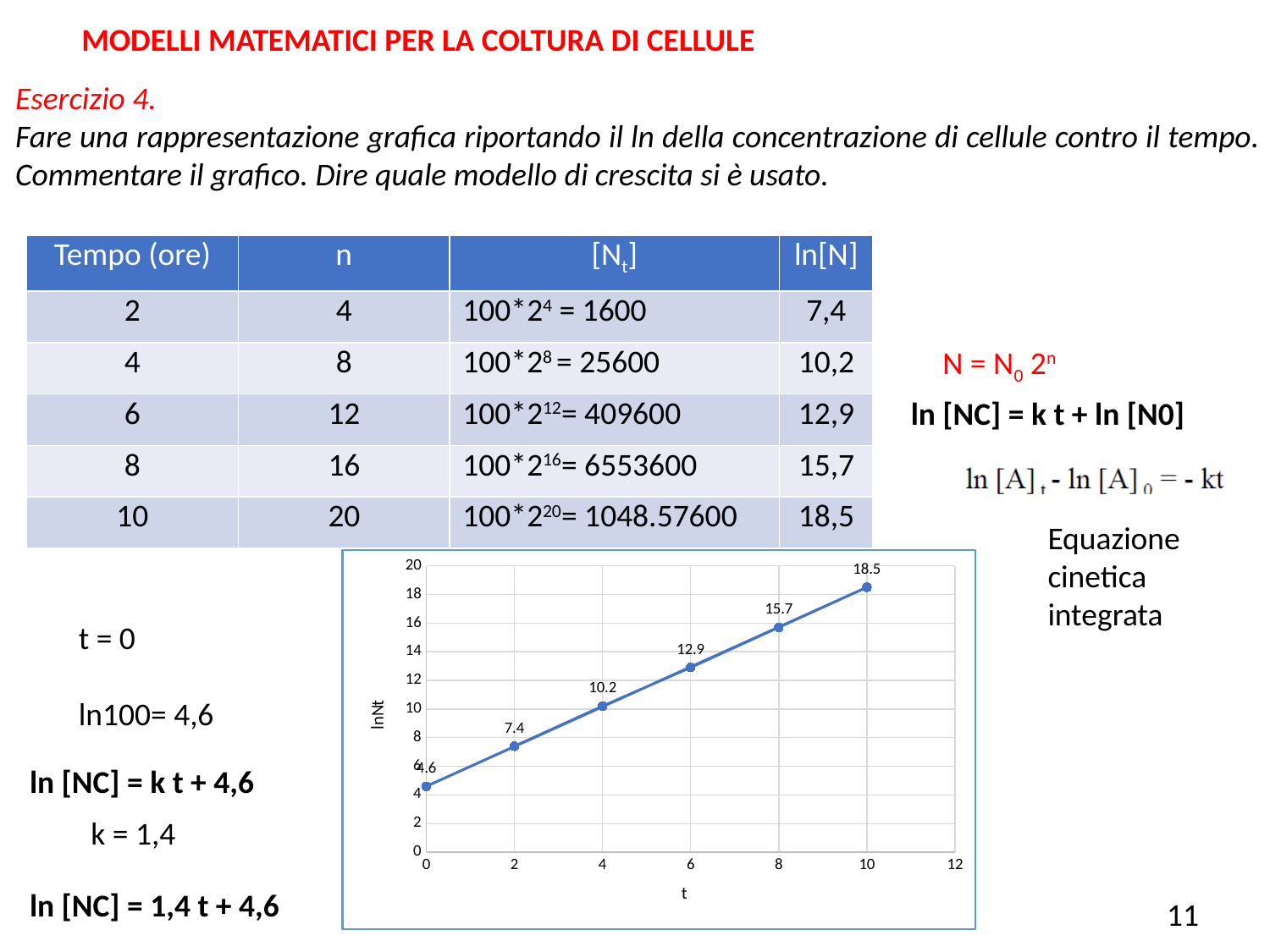
What is the value of lnNt at t = 10 in the chart? 18.5 Do the lnNt values rise or fall as t increases in the chart? rise What is the label of the vertical axis of the chart? lnNt At which value of t is lnNt highest in the chart? 10 What is the value of lnNt at t = 0 in the chart? 4.6 What is the value of lnNt at t = 2 in the chart? 7.4 At which value of t is lnNt lowest in the chart? 0 Which is larger in the chart: the lnNt value at t = 4 or at t = 8? t = 8 How many data points are plotted in the chart? 6 Is the lnNt value at t = 6 greater or less than 12? greater What is the difference between the lnNt values at t = 8 and t = 4 in the chart? 5.5 What is the value of lnNt at t = 6 in the chart? 12.9